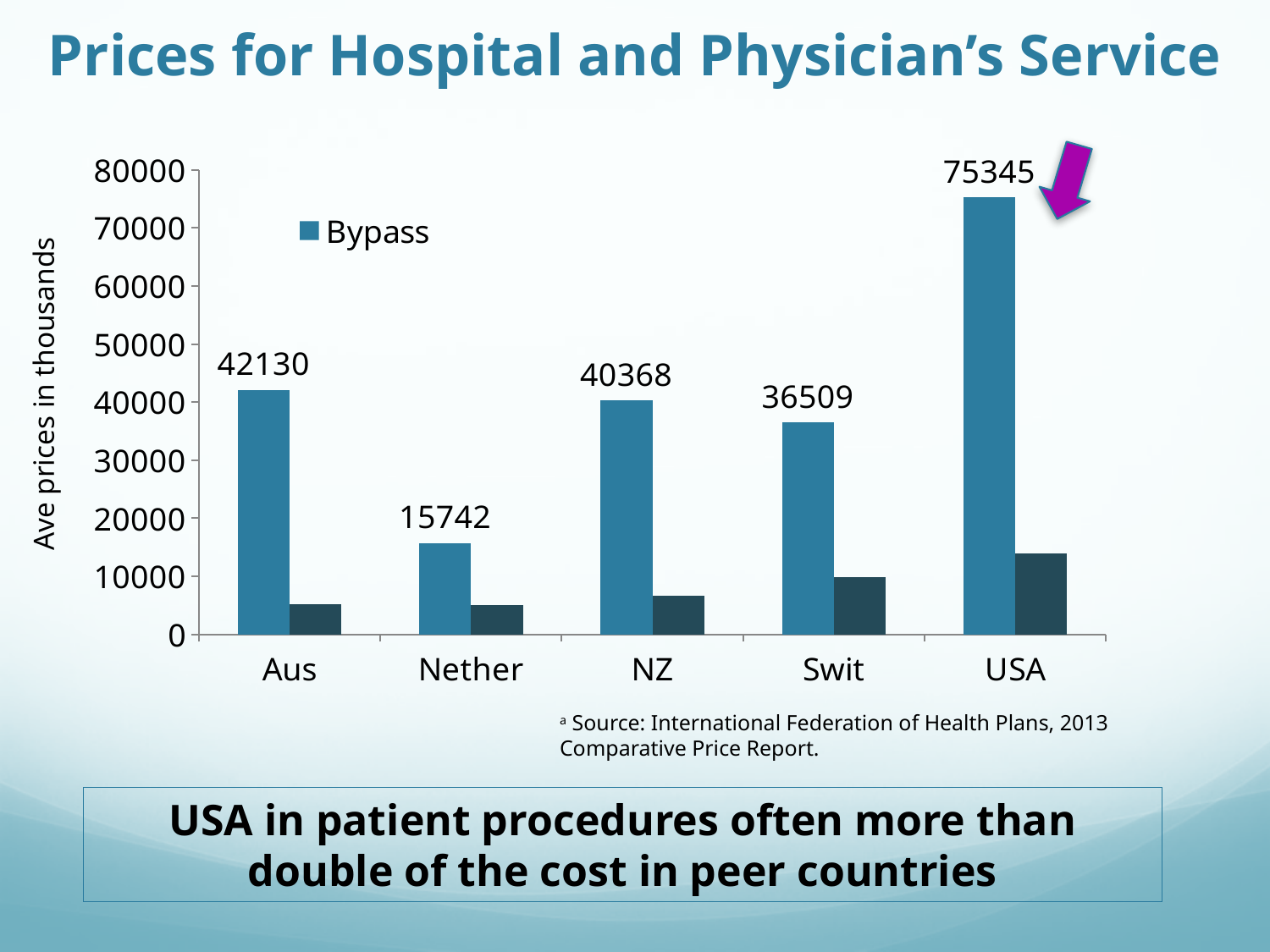
What is the Bypass value for Nether? 15742 How many series does the legend list? 1 What kind of chart is shown on the slide? bar chart What is the title of the vertical axis? Ave prices in thousands Which country has the highest Bypass value? USA Which has a larger Bypass value, NZ or Swit? NZ Which country has the lowest Bypass value? Nether What is the Bypass value for USA? 75345 Is the value of the dark bar for USA greater or less than 20000? less How many countries are shown on the x axis? 5 What is the difference between the Bypass values for USA and Aus? 33215 What is the Bypass value for Aus? 42130